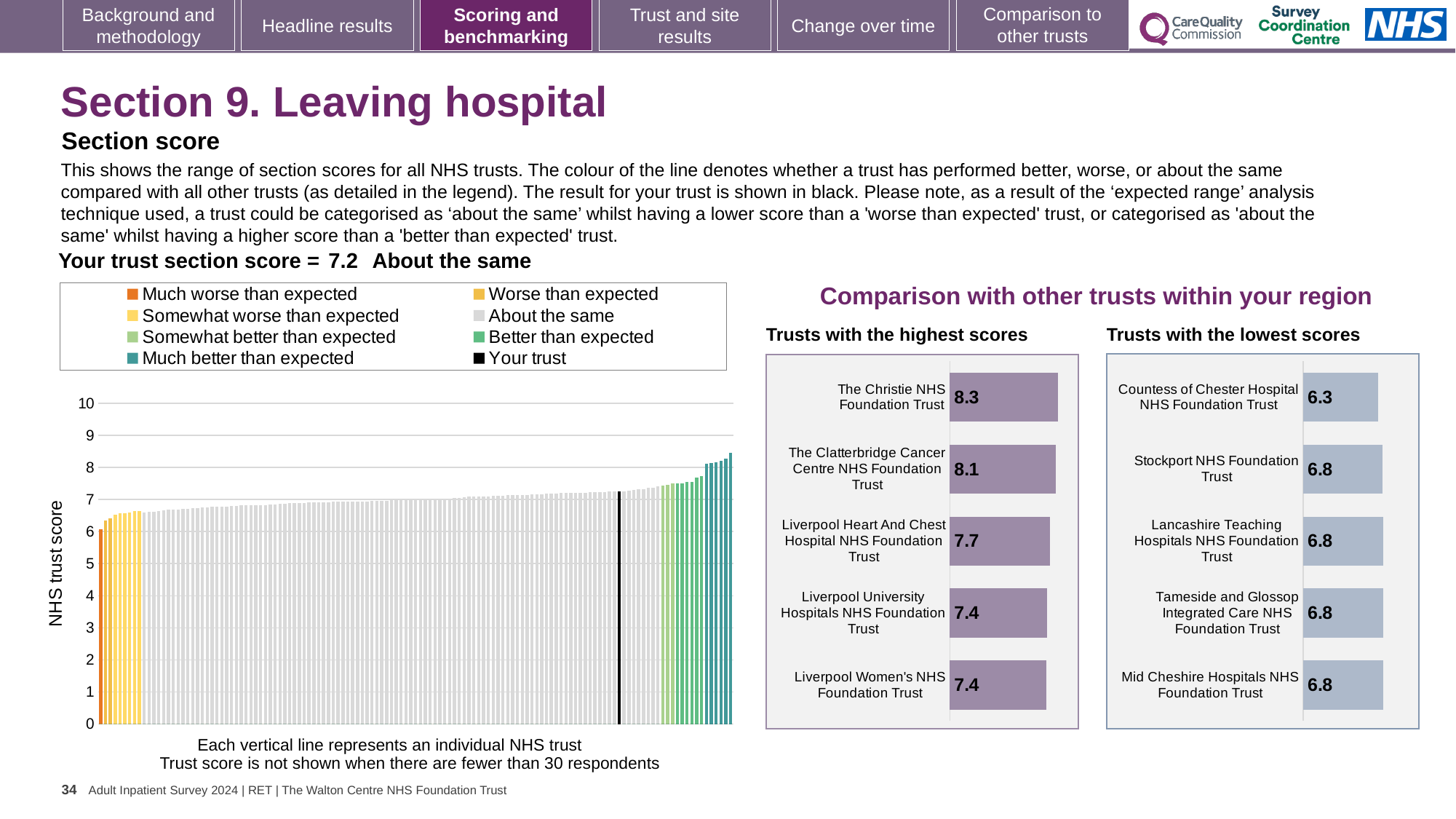
In the 'Trusts with the highest scores' chart, what is the score for The Christie NHS Foundation Trust? 8.3 In the main NHS trust score chart, what is the section score for your trust? 7.2 In the 'Trusts with the lowest scores' chart, which trust has the lowest score? Countess of Chester Hospital NHS Foundation Trust In the 'Trusts with the lowest scores' chart, what is the score for Countess of Chester Hospital NHS Foundation Trust? 6.3 In the main NHS trust score chart, do the trust scores rise or fall from left to right along the x axis? rise What kind of chart is the 'Trusts with the lowest scores' chart? bar chart In the 'Trusts with the highest scores' chart, which has the larger score: Liverpool Heart And Chest Hospital NHS Foundation Trust or Liverpool Women's NHS Foundation Trust? Liverpool Heart And Chest Hospital NHS Foundation Trust In the 'Trusts with the highest scores' chart, which trust has the highest score? The Christie NHS Foundation Trust How many trusts are shown in the 'Trusts with the lowest scores' chart? 5 How many trusts are shown in the 'Trusts with the highest scores' chart? 5 How many entries does the legend of the main NHS trust score chart list? 8 In the 'Trusts with the highest scores' chart, what is the difference between the scores of The Christie NHS Foundation Trust and The Clatterbridge Cancer Centre NHS Foundation Trust? 0.2